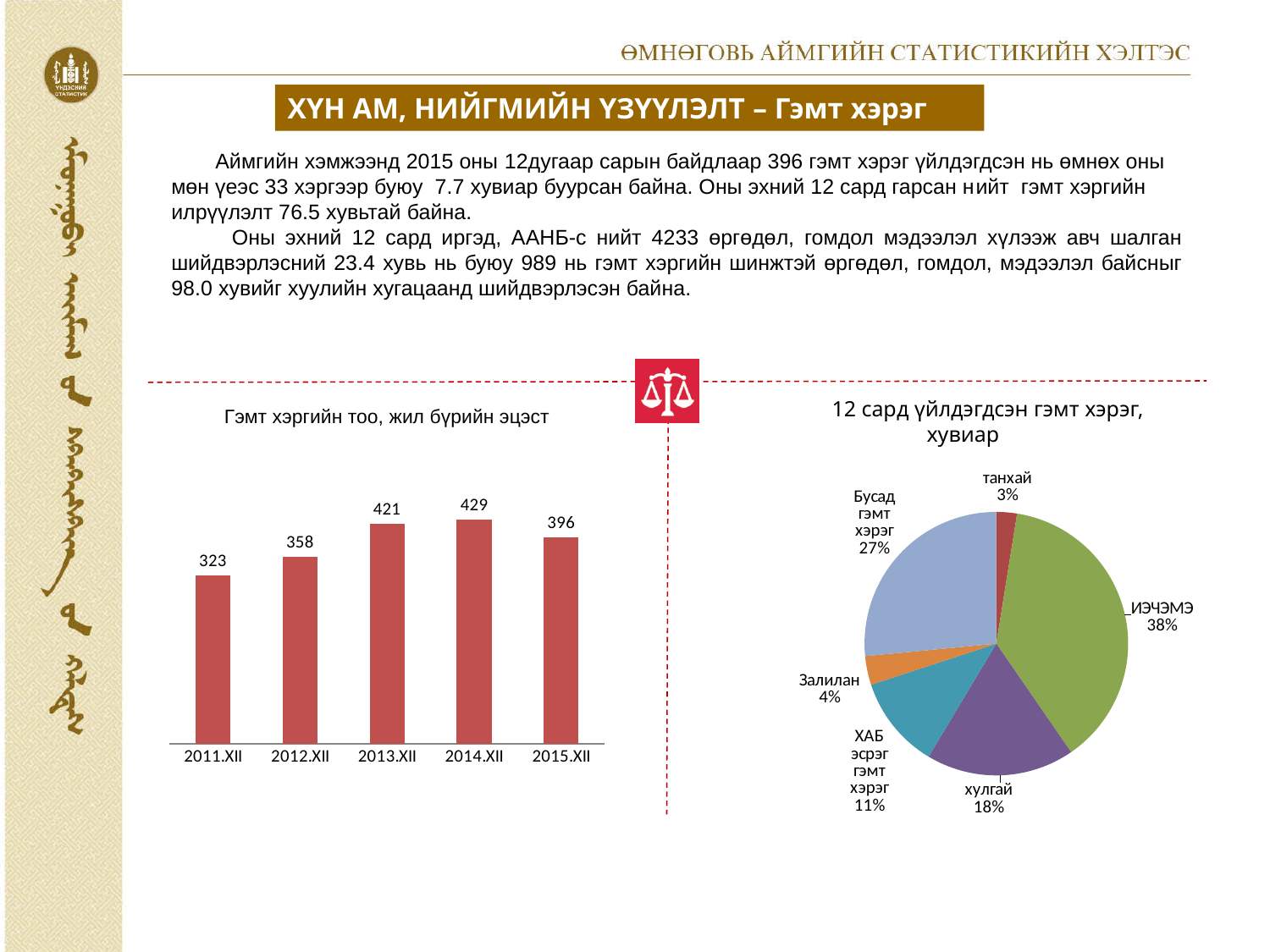
In the bar chart 'Гэмт хэргийн тоо, жил бүрийн эцэст', which year has the lowest value? 2011.XII How many slices are in the pie chart '12 сард үйлдэгдсэн гэмт хэрэг, хувиар'? 6 In the bar chart 'Гэмт хэргийн тоо, жил бүрийн эцэст', what is the value for 2013.XII? 421 In the bar chart 'Гэмт хэргийн тоо, жил бүрийн эцэст', what is the value for 2015.XII? 396 What kind of chart is the chart on the left of the slide? Bar chart In the pie chart '12 сард үйлдэгдсэн гэмт хэрэг, хувиар', which category has the smallest share? танхай In the pie chart '12 сард үйлдэгдсэн гэмт хэрэг, хувиар', what share does хулгай have? 18% How many bars are in the bar chart 'Гэмт хэргийн тоо, жил бүрийн эцэст'? 5 In the bar chart 'Гэмт хэргийн тоо, жил бүрийн эцэст', which is larger, the value for 2012.XII or 2013.XII? 2013.XII In the bar chart 'Гэмт хэргийн тоо, жил бүрийн эцэст', what is the difference between the values for 2014.XII and 2015.XII? 33 In the pie chart '12 сард үйлдэгдсэн гэмт хэрэг, хувиар', what share does ИЭЧЭМЭ have? 38% In the bar chart 'Гэмт хэргийн тоо, жил бүрийн эцэст', which year has the highest value? 2014.XII